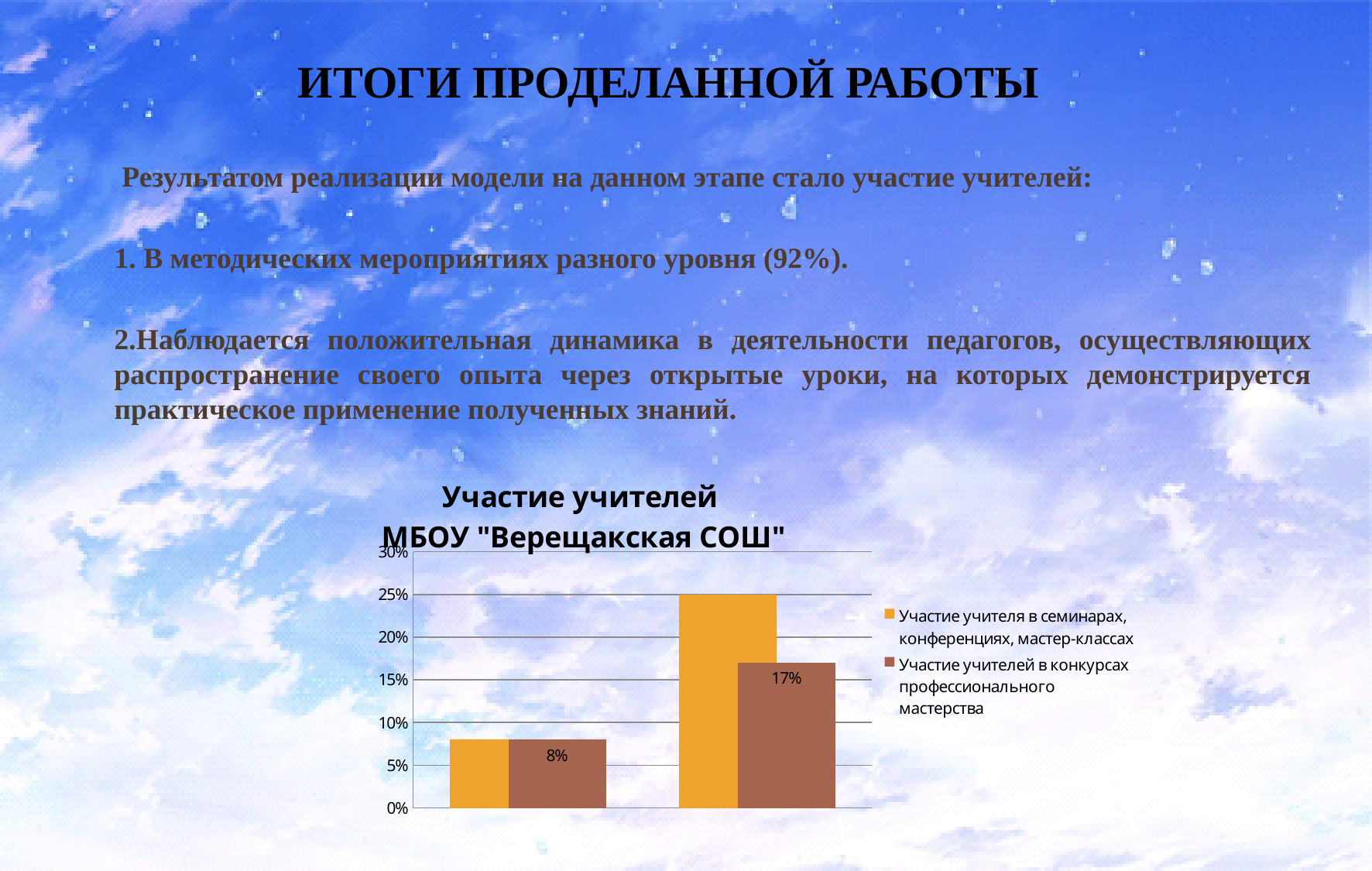
Is the value of the 'Участие учителя в семинарах, конференциях, мастер-классах' series in the left group greater or less than 10%? less In the right group of bars, which series has the larger value? Участие учителя в семинарах, конференциях, мастер-классах How many series does the legend of the chart list? 2 What is the title of the chart? Участие учителей МБОУ "Верещакская СОШ" What is the value of the 'Участие учителей в конкурсах профессионального мастерства' series in the left group of bars? 8% Does the 'Участие учителей в конкурсах профессионального мастерства' series rise or fall from the left group to the right group? rise Is the value of the 'Участие учителя в семинарах, конференциях, мастер-классах' series in the right group greater or less than 20%? greater How many groups of bars are plotted in the chart? 2 What is the value of the 'Участие учителя в семинарах, конференциях, мастер-классах' series in the right group of bars? 25% What kind of chart is shown on the slide? bar chart By how much does the 'Участие учителей в конкурсах профессионального мастерства' value in the right group exceed the value in the left group? 9% What is the value of the 'Участие учителей в конкурсах профессионального мастерства' series in the right group of bars? 17%